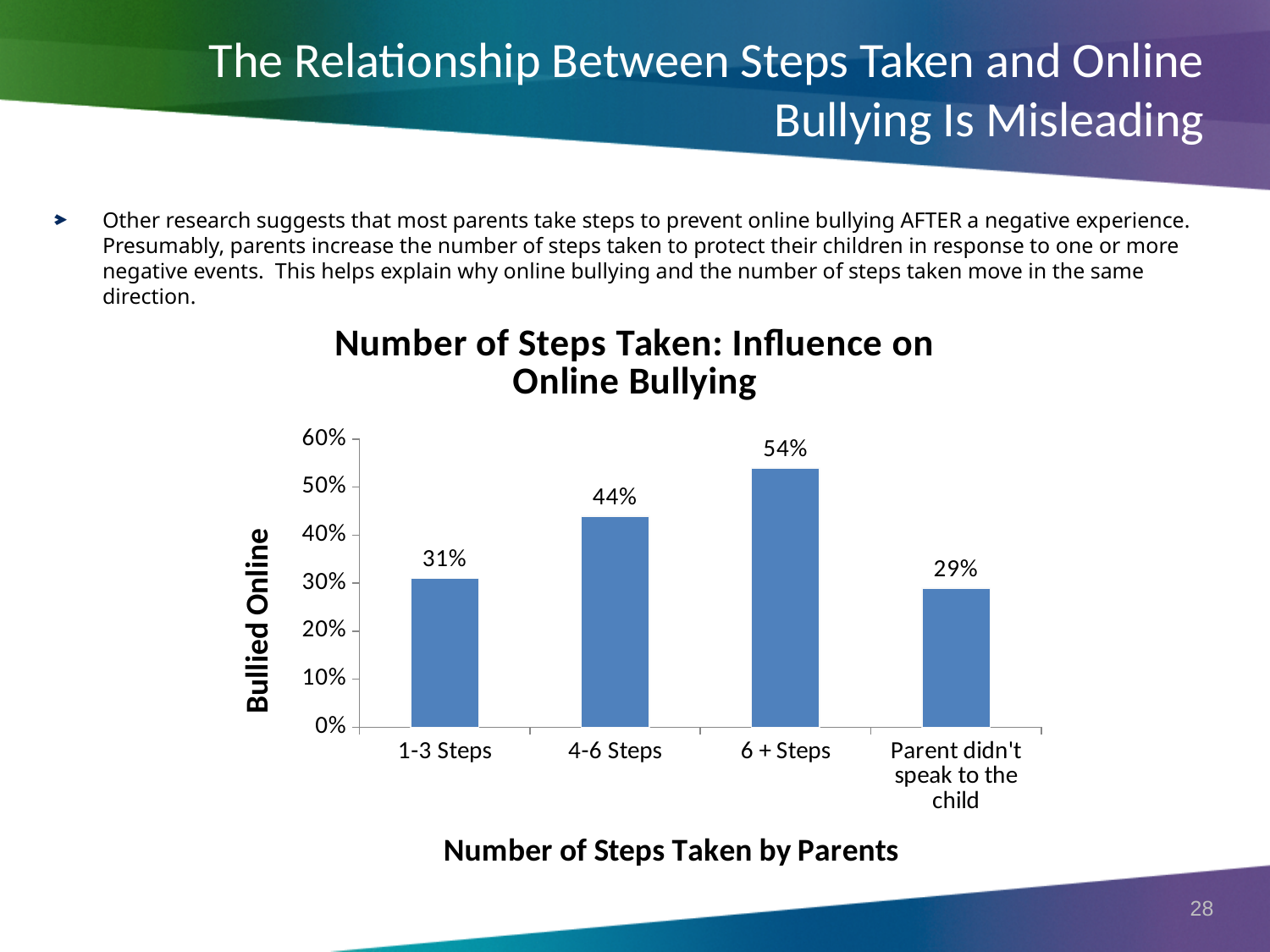
What is the value for the '6 + Steps' category? 54% What is the difference between the values for '4-6 Steps' and 'Parent didn't speak to the child'? 15% Which is larger, the value for '4-6 Steps' or the value for '1-3 Steps'? 4-6 Steps What kind of chart is shown on the slide? Bar chart Which category has the lowest percentage bullied online? Parent didn't speak to the child How many categories are shown on the x axis? 4 What percentage is shown for 'Parent didn't speak to the child'? 29% What is the difference between the values for '6 + Steps' and '1-3 Steps'? 23% Is the value for '6 + Steps' greater or less than 50%? greater What is the title of the chart? Number of Steps Taken: Influence on Online Bullying What percentage of children were bullied online when parents took 1-3 steps? 31% Which category has the highest percentage bullied online? 6 + Steps